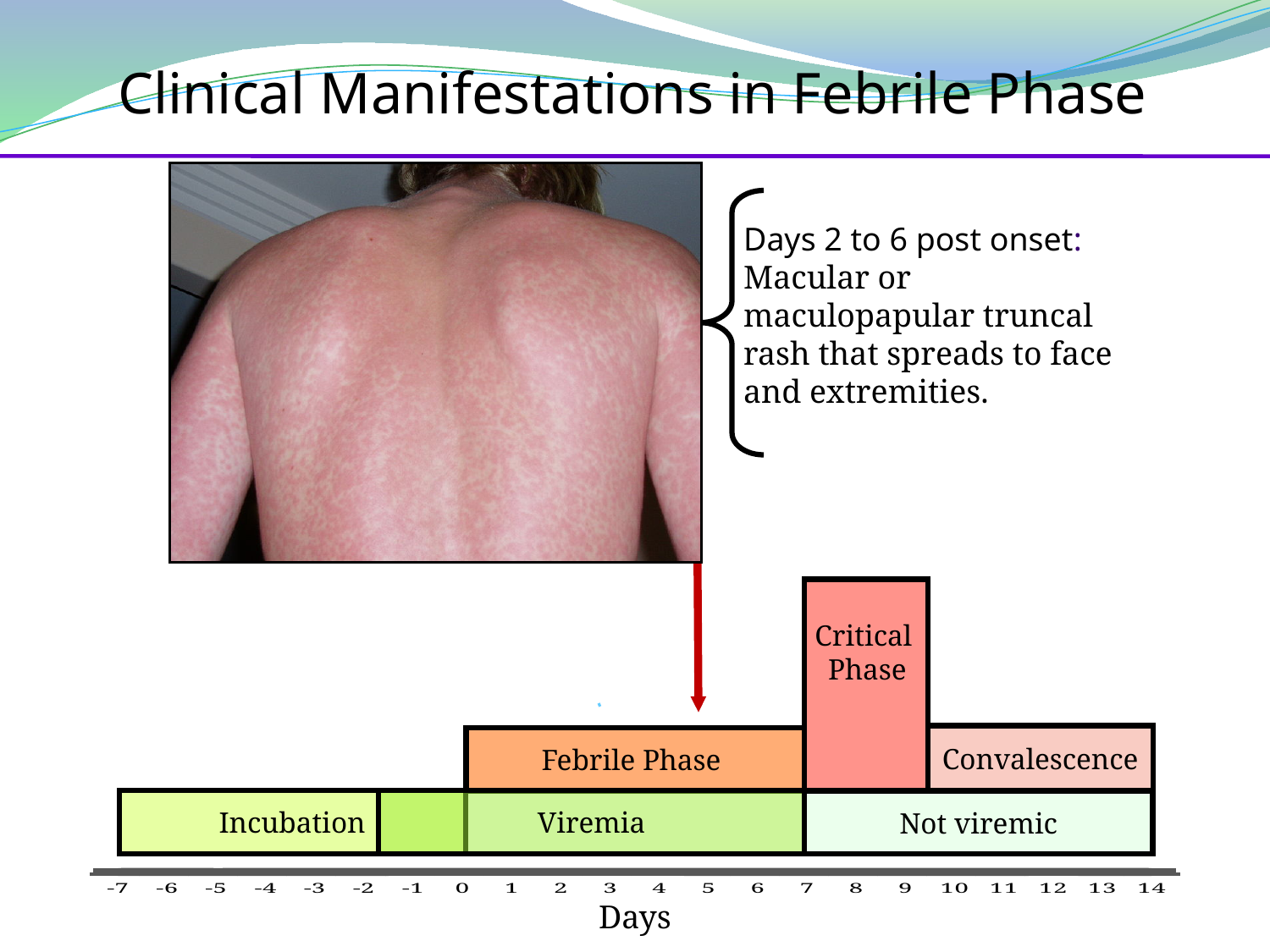
On what day does the Critical Phase begin on the timeline chart? 7 Which phase immediately follows the Febrile Phase on the timeline chart? Critical Phase What is the highest value shown on the Days axis of the timeline chart? 14 Which phase on the timeline chart is drawn as the tallest block? Critical Phase On the timeline chart, what is the lower-row label at day 3? Viremia On the timeline chart, what is the lower-row label at day -5? Incubation On the timeline chart, what is the lower-row label covering days 7 to 14? Not viremic What is the lowest value shown on the Days axis of the timeline chart? -7 How many labeled phase segments are shown on the timeline chart? 6 Which phase is shown after the Critical Phase on the timeline chart? Convalescence What is the label on the horizontal axis of the timeline chart? Days Which phase in the upper row of the timeline chart spans from day 0 to day 7? Febrile Phase